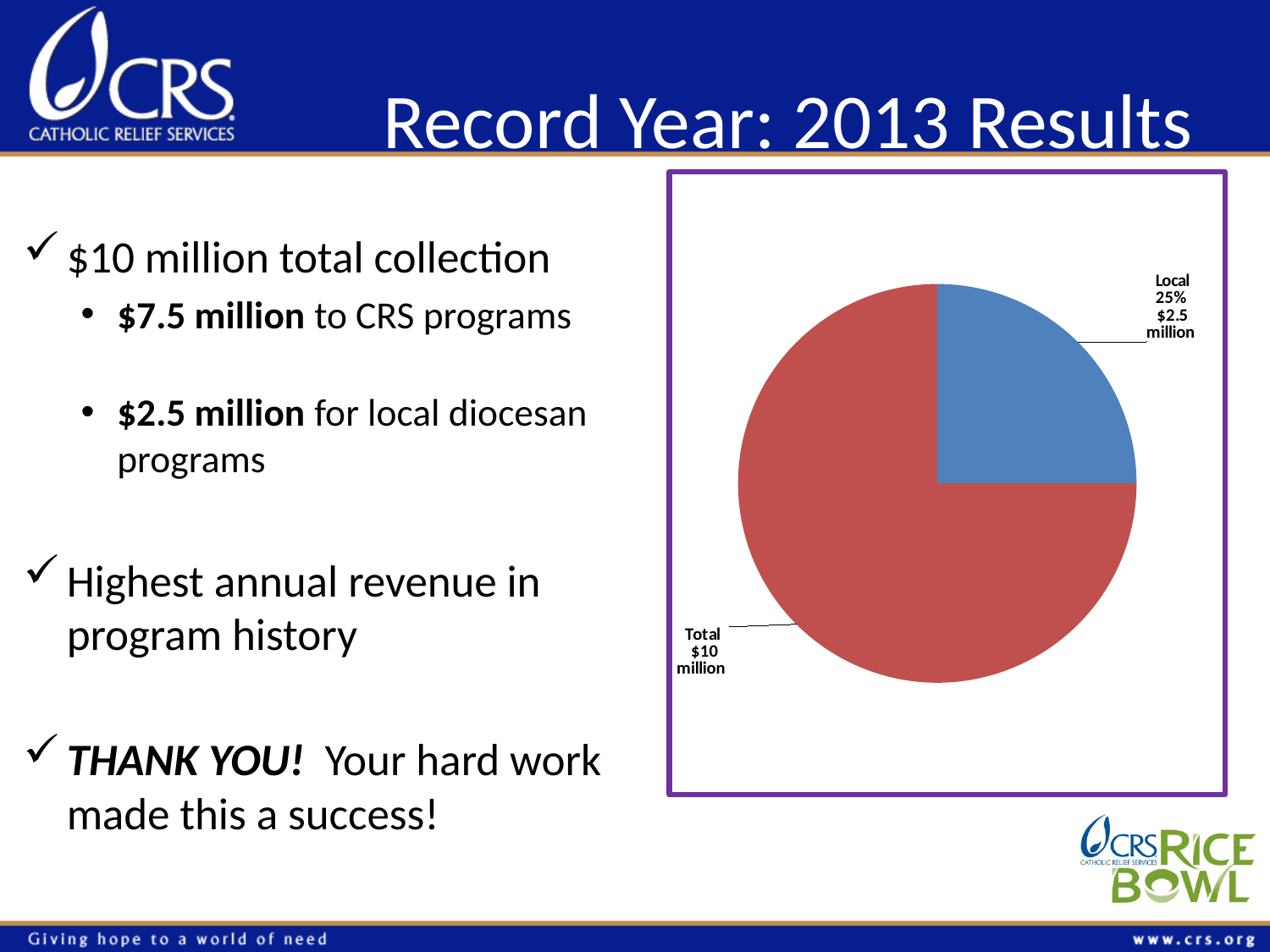
What colour is the Total slice of the pie chart? red Which slice of the pie chart is larger, Local or Total? Total What colour is the Local slice of the pie chart? blue What dollar amount is labelled on the Local slice of the pie chart? $2.5 million Which slice of the pie chart is the smallest? Local What kind of chart is shown on the slide? pie chart What percentage is shown for the Local slice of the pie chart? 25% What dollar amount is labelled on the Total slice of the pie chart? $10 million How many slices does the pie chart have? 2 Which slice of the pie chart is the largest? Total